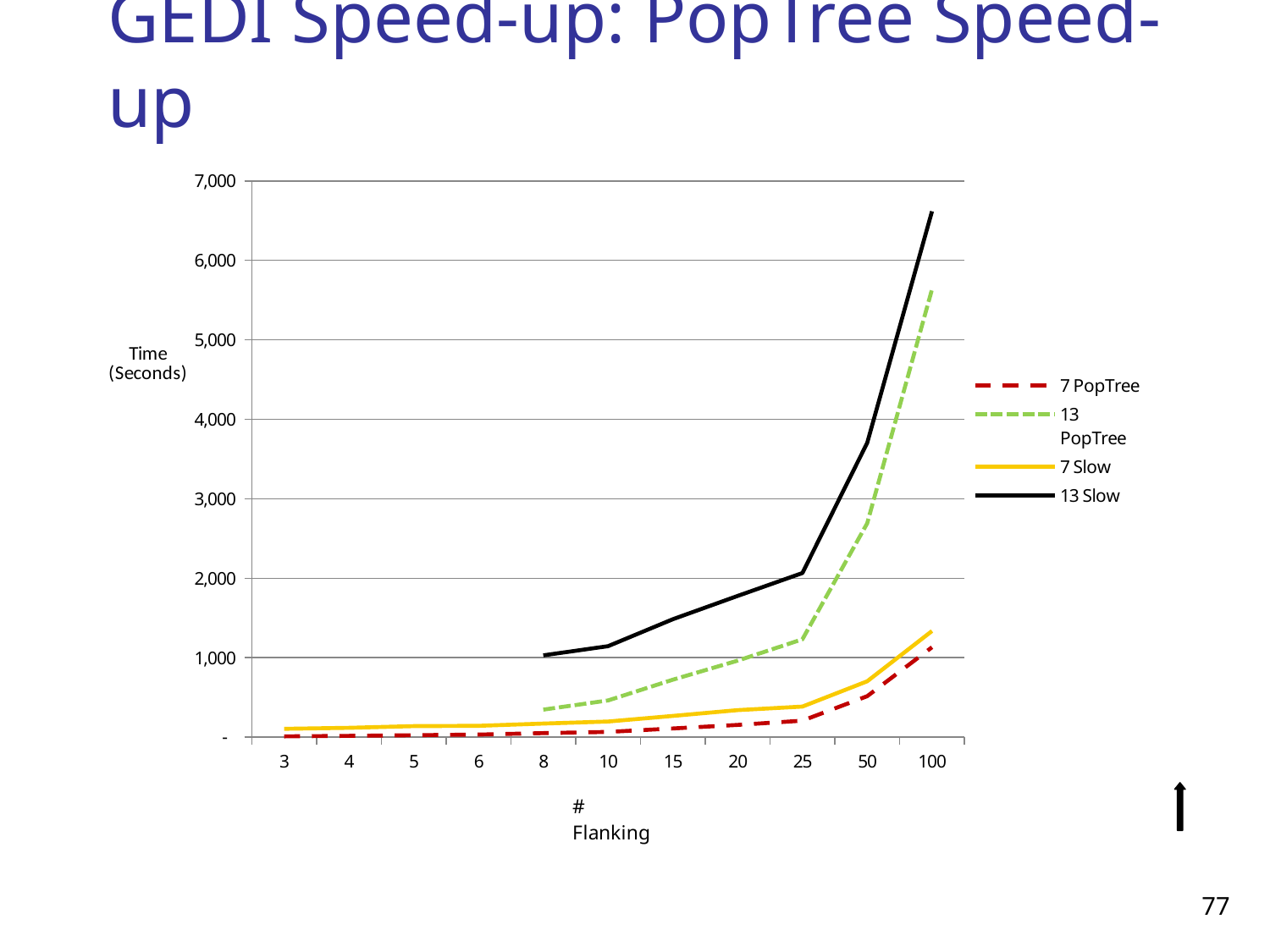
Which series has the lowest time at # Flanking = 100? 7 PopTree Is the value for 7 Slow at # Flanking = 50 greater or less than 1,000? less Is the value for 13 Slow at # Flanking = 100 greater or less than 6,000? greater How many # Flanking values are marked along the x axis? 11 What is the label of the y axis? Time (Seconds) Is the value for 13 PopTree at # Flanking = 100 greater or less than 5,000? greater Which series reaches the highest time at # Flanking = 100? 13 Slow Does the 13 Slow series rise or fall as # Flanking increases? rise What kind of chart is shown on the slide? line chart How many series does the legend list? 4 At # Flanking = 50, which is larger: 13 Slow or 13 PopTree? 13 Slow